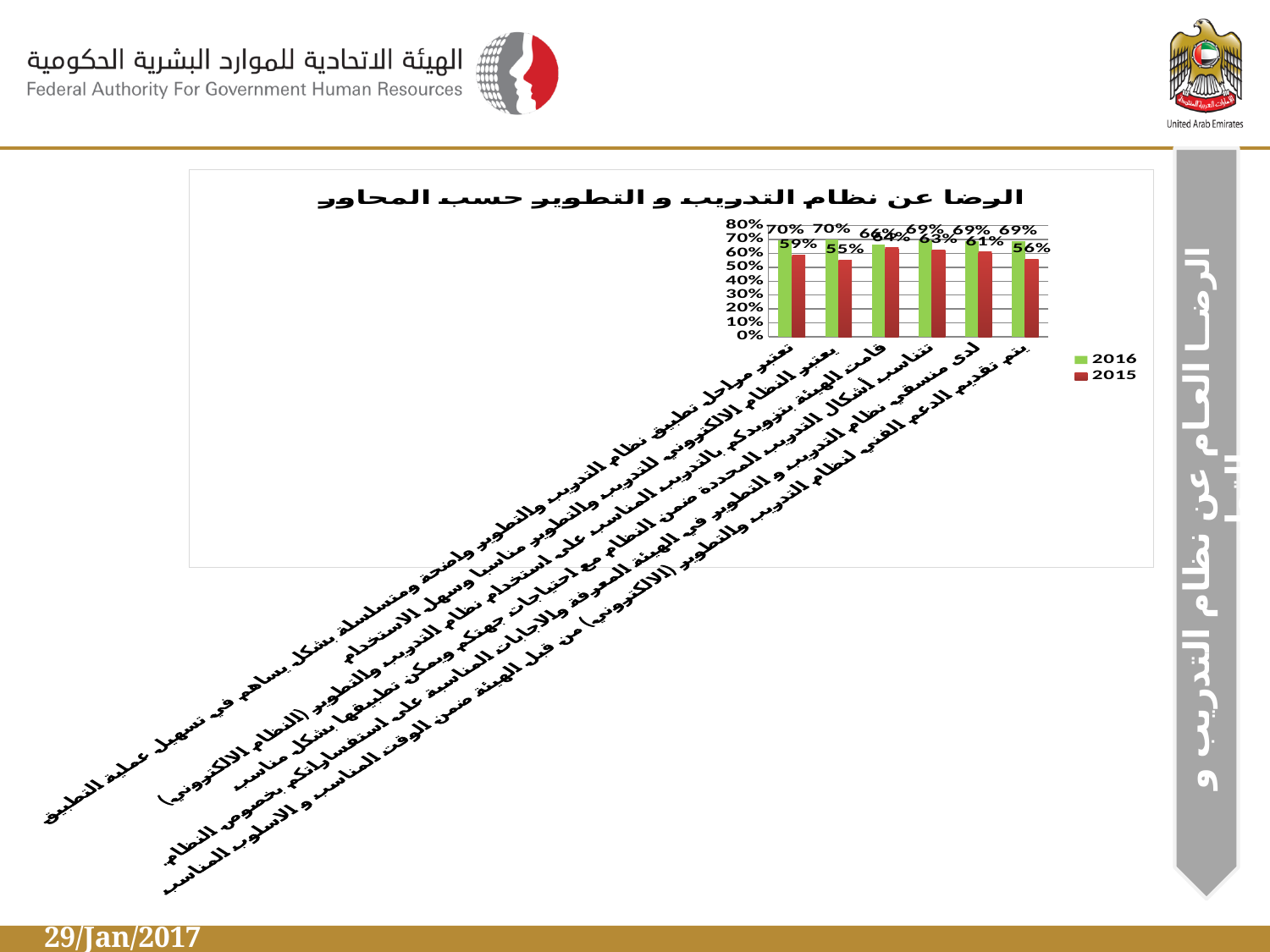
What kind of chart is shown on the slide? Bar chart Which category has the lowest 2015 value? The second category from the left (55%) What is the difference between the 2016 and 2015 values for the leftmost category? 11 percentage points What is the 2015 value for the leftmost category in the chart? 59% For the rightmost category, which year has the higher value, 2016 or 2015? 2016 What is the 2015 value for the rightmost category in the chart? 56% Which years are listed in the chart legend? 2016 and 2015 What is the 2016 value for the leftmost category in the chart? 70% Is the 2015 value for the rightmost category greater or less than 60%? less How many series does the chart legend list? 2 What is the 2015 value for the second category from the left? 55% How many categories are plotted along the x axis of the chart? 6